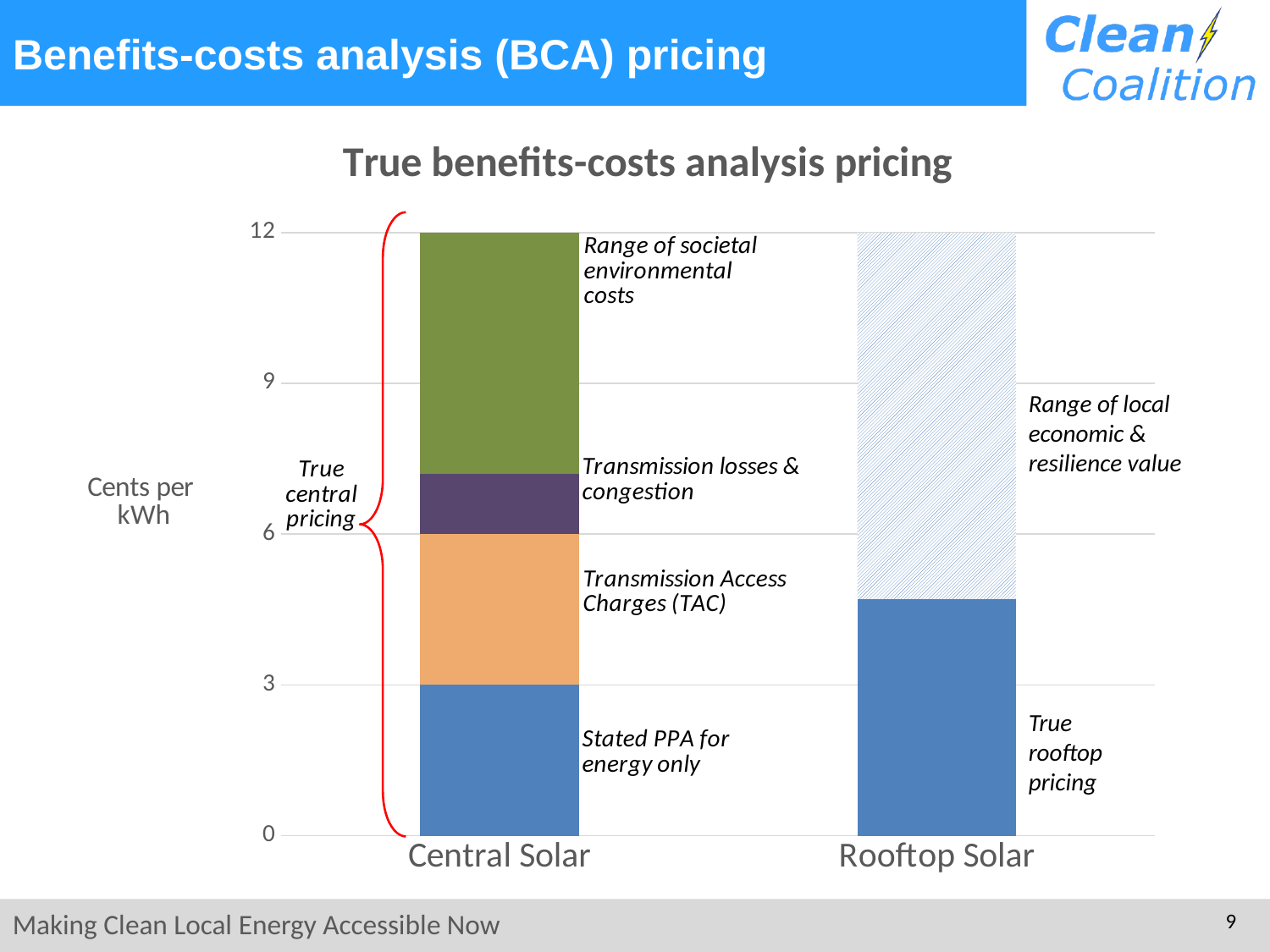
What unit is shown on the y axis of the chart? Cents per kWh Which segment of the Central Solar bar is the largest? Range of societal environmental costs Which is larger: the 'True rooftop pricing' for Rooftop Solar or the 'Stated PPA for energy only' for Central Solar? True rooftop pricing Is the 'True rooftop pricing' value for Rooftop Solar greater or less than 6? less What is the value of the 'Stated PPA for energy only' segment for Central Solar? 3 What is the title of the chart? True benefits-costs analysis pricing How many categories are shown on the x axis of the chart? 2 Which segment of the Central Solar bar is the smallest? Transmission losses & congestion What is the total height of the Central Solar stacked bar in cents per kWh? 12 What kind of chart is shown on the slide? Stacked bar chart Is the 'True rooftop pricing' value for Rooftop Solar greater or less than 3? greater Is the 'Transmission losses & congestion' segment for Central Solar greater or less than 3 cents per kWh? less